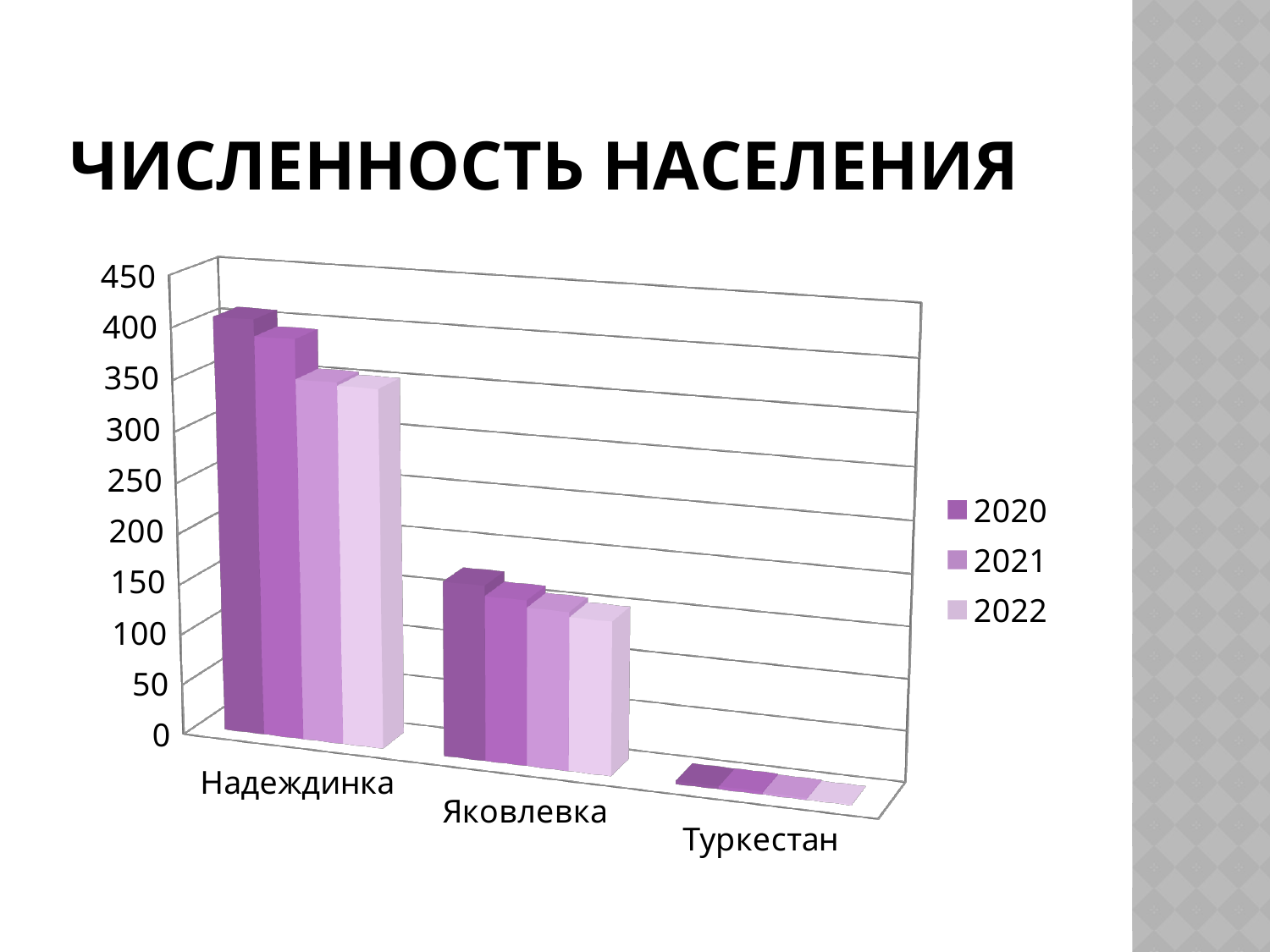
Is the 2022 value for Туркестан greater or less than 50? less What is the title of the chart? ЧИСЛЕННОСТЬ НАСЕЛЕНИЯ How many categories are shown on the x axis? 3 Which series is shown in the lightest shade of purple? 2022 Which category has the highest population values? Надеждинка How many series does the legend list? 3 Is the 2020 value for Надеждинка greater or less than 350? greater Which category has the lowest population values? Туркестан Which is larger, the 2020 value for Надеждинка or the 2020 value for Яковлевка? Надеждинка What type of chart is shown on the slide? bar chart Is the 2020 value for Яковлевка greater or less than 200? less For Надеждинка, do the values rise or fall from 2020 to 2022? fall